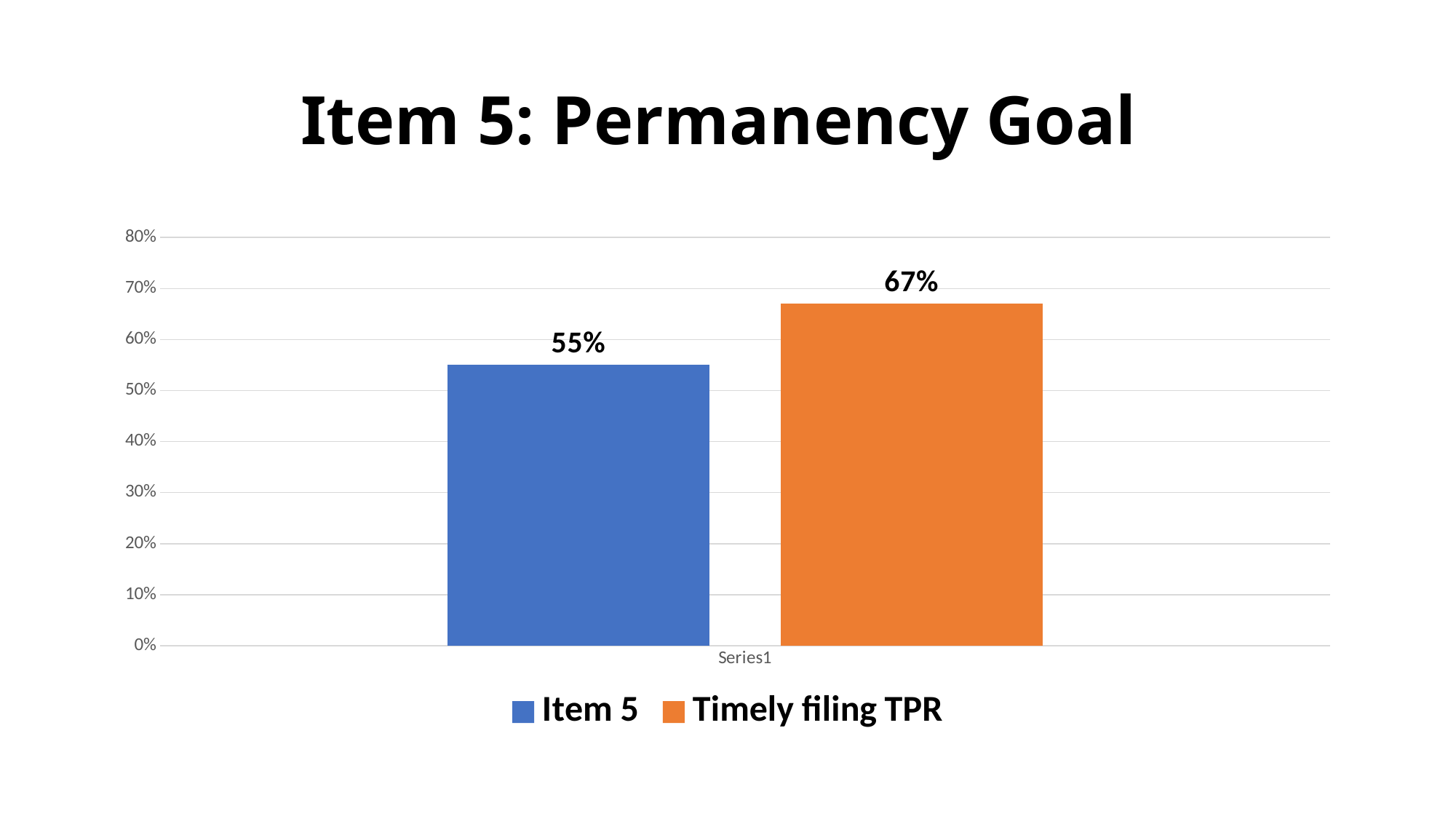
What kind of chart is shown on the slide? bar chart Which series has the highest value? Timely filing TPR Is the value for Item 5 greater or less than 60%? less Which is larger, the value for Item 5 or the value for Timely filing TPR? Timely filing TPR What is the title of the slide? Item 5: Permanency Goal What colour is the bar for Timely filing TPR? orange How many series does the legend list? 2 What is the value for Timely filing TPR? 67% Is the value for Timely filing TPR greater or less than 60%? greater What is the value for Item 5? 55% What is the difference between the Timely filing TPR value and the Item 5 value? 12% Which series has the lowest value? Item 5